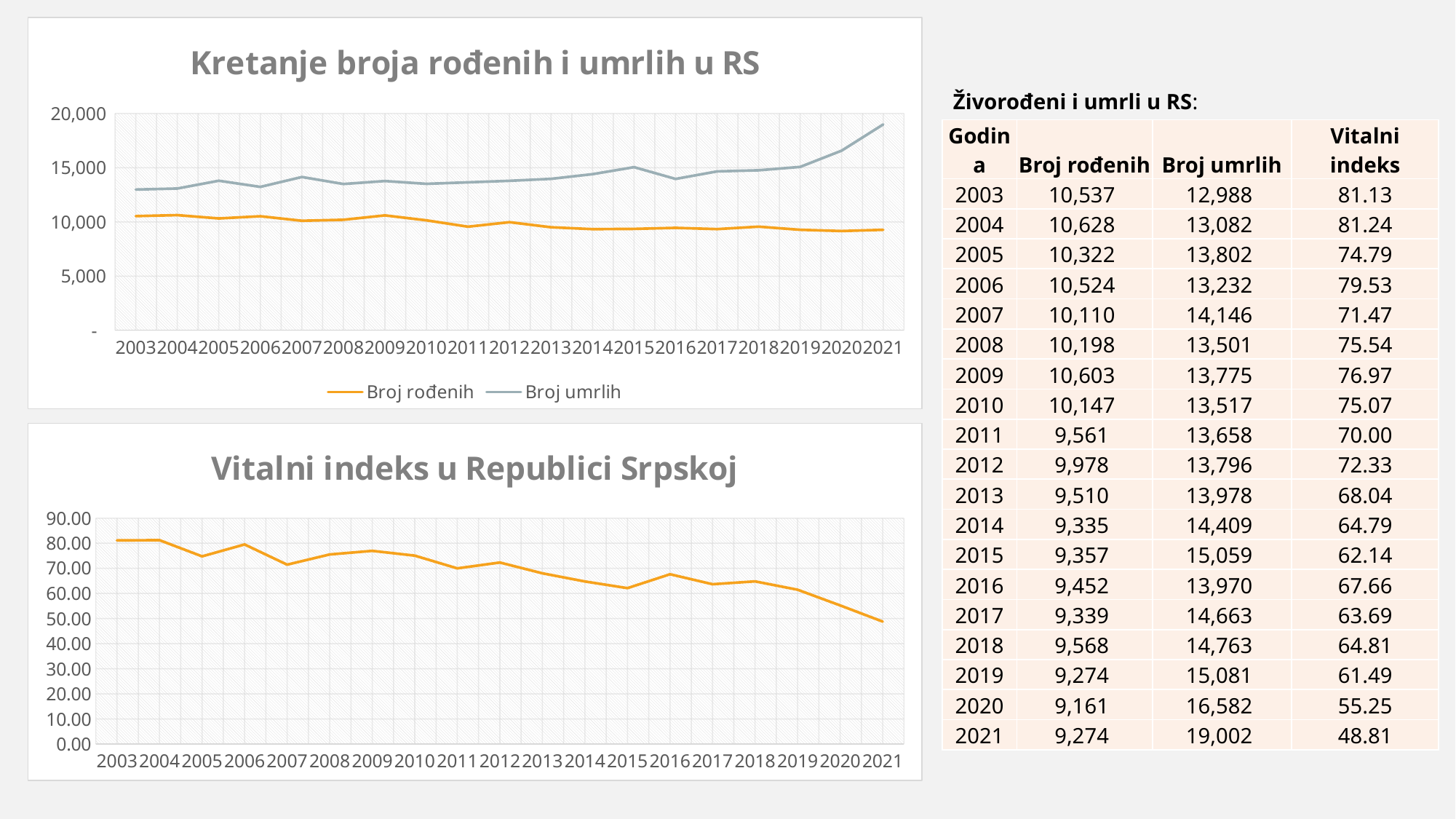
What kind of chart is the 'Kretanje broja rođenih i umrlih u RS' chart? line chart In the 'Kretanje broja rođenih i umrlih u RS' chart, is the value of Broj rođenih in 2003 greater or less than 10,000? greater In the 'Vitalni indeks u Republici Srpskoj' chart, what is the value for 2003? 81.13 In the 'Kretanje broja rođenih i umrlih u RS' chart, which year has the highest value of Broj umrlih? 2021 In the 'Kretanje broja rođenih i umrlih u RS' chart, is the value of Broj umrlih in 2021 greater or less than 15,000? greater In the 'Kretanje broja rođenih i umrlih u RS' chart, what is the difference between Broj umrlih and Broj rođenih in 2021? 9,728 In the 'Vitalni indeks u Republici Srpskoj' chart, do the values generally rise or fall from 2003 to 2021? fall How many series does the legend of the 'Kretanje broja rođenih i umrlih u RS' chart list? 2 In the 'Vitalni indeks u Republici Srpskoj' chart, which year has the lowest value? 2021 In the 'Kretanje broja rođenih i umrlih u RS' chart, what is the value of Broj umrlih in 2021? 19,002 In the 'Kretanje broja rođenih i umrlih u RS' chart, which series has the larger value in 2015, Broj rođenih or Broj umrlih? Broj umrlih How many years are plotted on the x axis of the 'Vitalni indeks u Republici Srpskoj' chart? 19